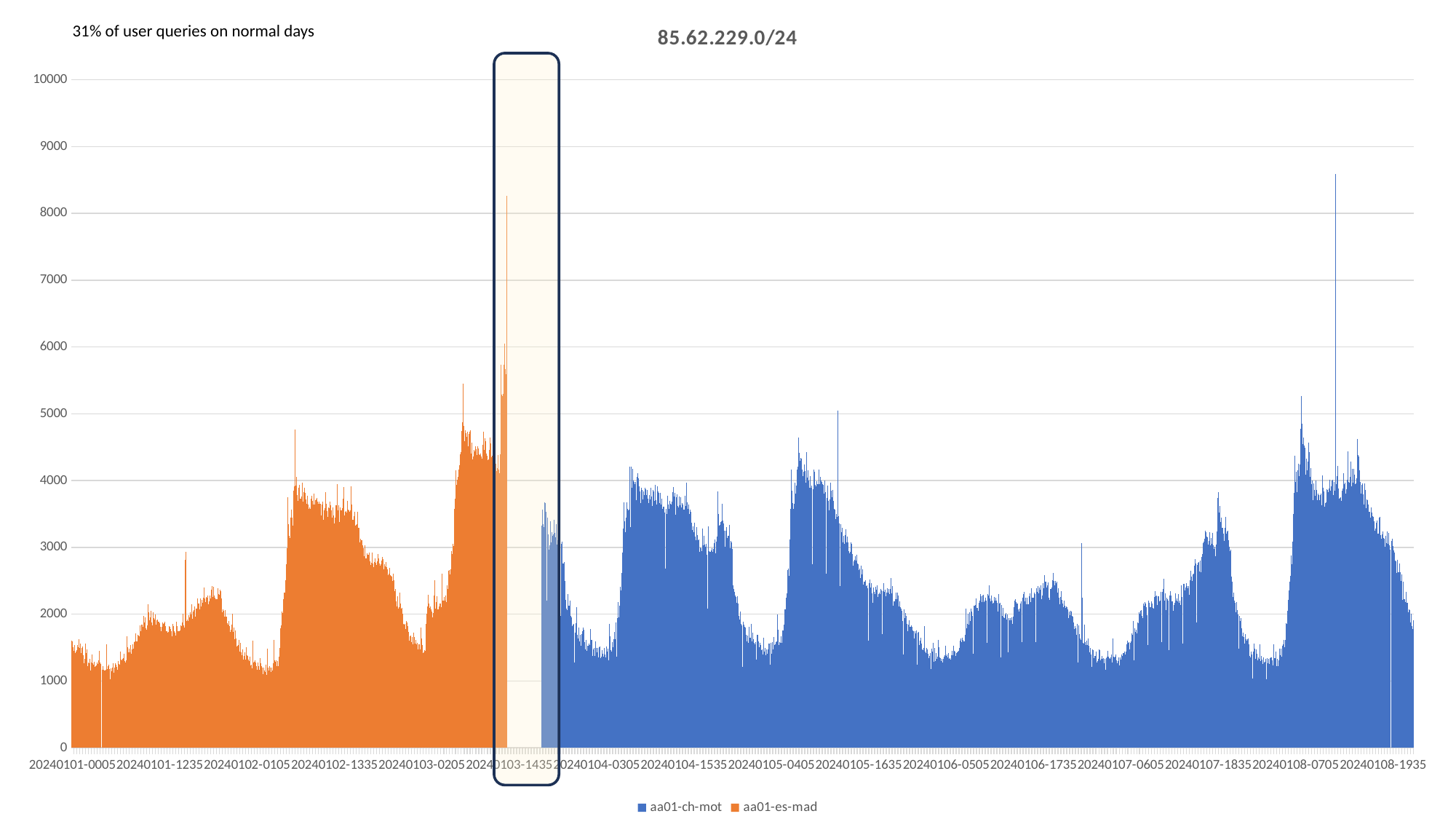
Which series is drawn in orange? aa01-es-mad What is the first label on the horizontal axis? 20240101-0005 Is the value for aa01-es-mad at 20240101-0005 greater or less than 2000? less Is the value for aa01-ch-mot around 20240106-0505 greater or less than 2000? less What is the highest value shown on the vertical axis? 10000 What is the title of the chart? 85.62.229.0/24 Is the highest peak of the aa01-es-mad series greater or less than 8000? greater How many series does the legend list? 2 What kind of chart is shown on the slide? bar chart